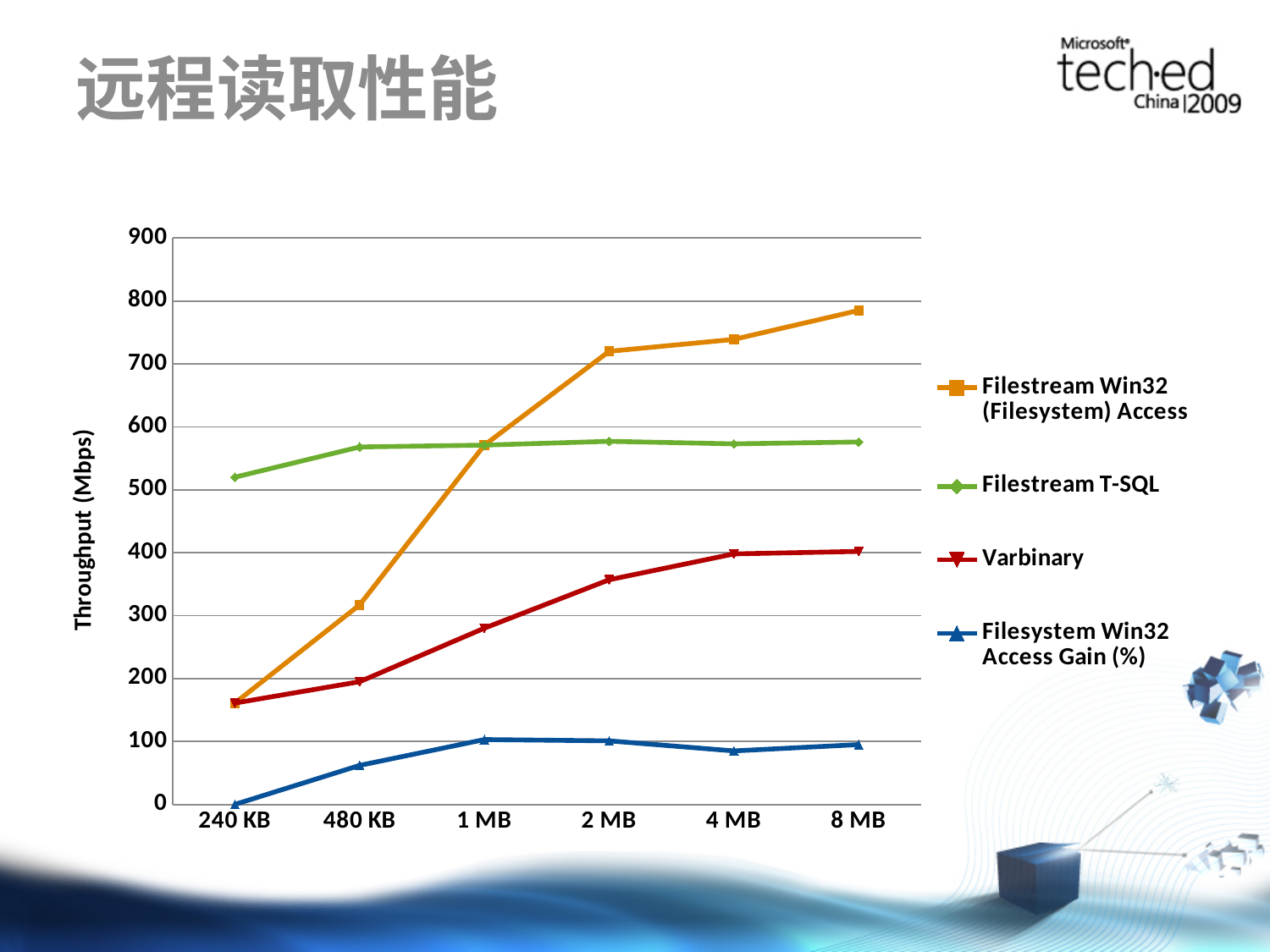
Which series has the highest value at 240 KB? Filestream T-SQL Is the value for Filesystem Win32 Access Gain (%) at 4 MB greater or less than 100? less Which series has the highest value at 8 MB? Filestream Win32 (Filesystem) Access Does the Varbinary series rise or fall as file size increases from 240 KB to 8 MB? rise What kind of chart is shown on the slide? line chart How many series does the legend list? 4 Is the value for Filestream T-SQL at 240 KB greater or less than 500? greater Which series has the lowest value at 8 MB? Filesystem Win32 Access Gain (%) How many file-size categories are shown on the x axis? 6 Is the value for Filestream Win32 (Filesystem) Access at 8 MB greater or less than 700? greater What is the label of the vertical axis? Throughput (Mbps) At 480 KB, which is larger: Filestream Win32 (Filesystem) Access or Varbinary? Filestream Win32 (Filesystem) Access